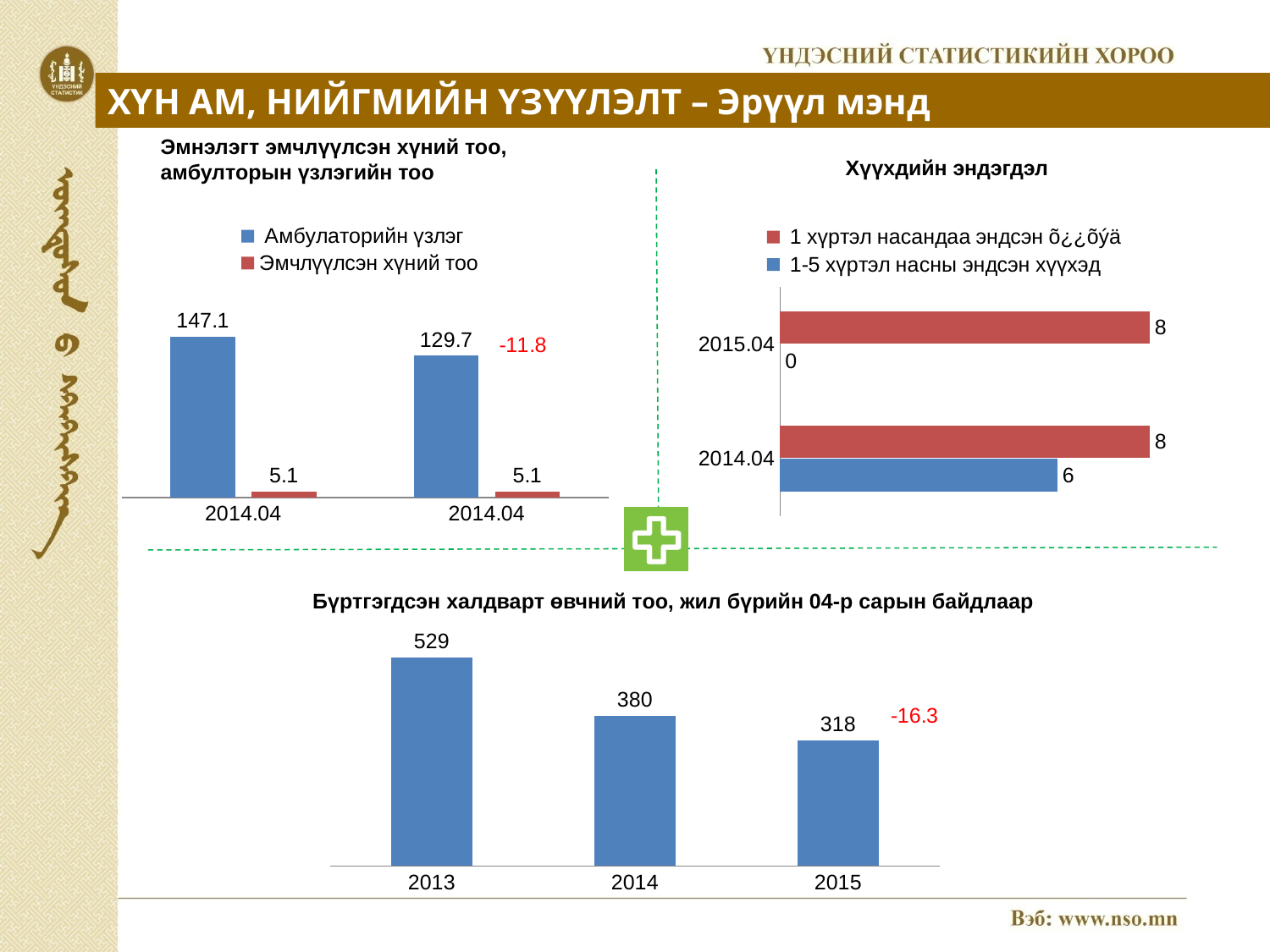
In the top-right chart titled 'Хүүхдийн эндэгдэл', what is the value of the '1-5 хүртэл насны эндсэн хүүхэд' series for 2014.04? 6 In the bottom chart titled 'Бүртгэгдсэн халдварт өвчний тоо, жил бүрийн 04-р сарын байдлаар', how many years are shown? 3 In the bottom chart titled 'Бүртгэгдсэн халдварт өвчний тоо, жил бүрийн 04-р сарын байдлаар', what is the value for 2013? 529 In the top-left chart, how many series does the legend list? 2 In the top-right chart titled 'Хүүхдийн эндэгдэл', what kind of chart is used? bar chart In the bottom chart titled 'Бүртгэгдсэн халдварт өвчний тоо, жил бүрийн 04-р сарын байдлаар', what is the value for 2015? 318 In the bottom chart titled 'Бүртгэгдсэн халдварт өвчний тоо, жил бүрийн 04-р сарын байдлаар', do the values rise or fall from 2013 to 2015? fall In the top-left chart, what is the value of the 'Эмчлүүлсэн хүний тоо' series for the right-hand group of bars? 5.1 In the top-right chart titled 'Хүүхдийн эндэгдэл', what is the value of the '1-5 хүртэл насны эндсэн хүүхэд' series for 2015.04? 0 In the bottom chart titled 'Бүртгэгдсэн халдварт өвчний тоо, жил бүрийн 04-р сарын байдлаар', what is the difference between the 2014 and 2015 values? 62 In the top-left chart, what is the value of the 'Амбулаторийн үзлэг' series for the left-hand group of bars? 147.1 In the bottom chart titled 'Бүртгэгдсэн халдварт өвчний тоо, жил бүрийн 04-р сарын байдлаар', which year has the highest value? 2013